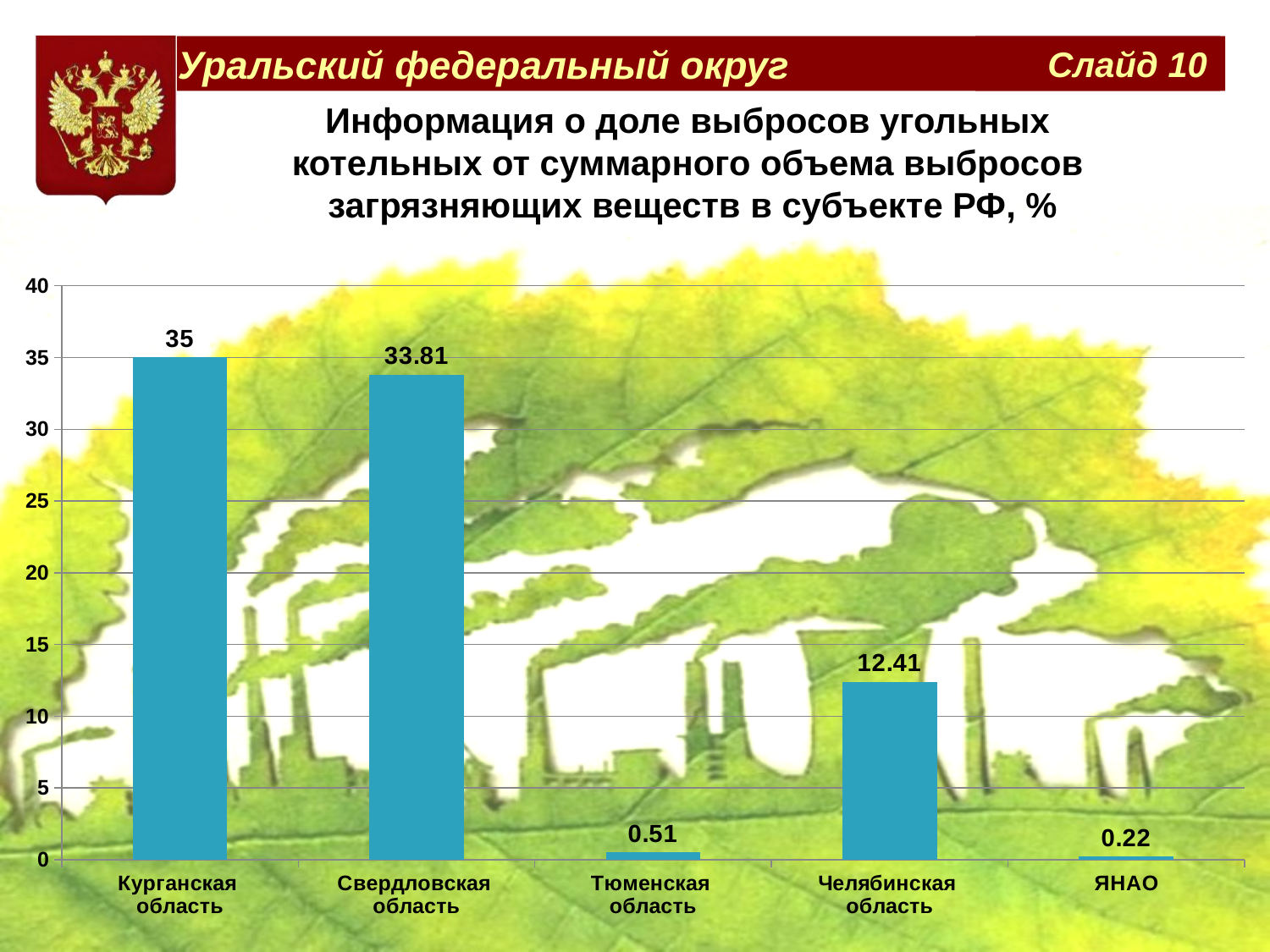
How many categories are shown on the x axis? 5 What is the difference between the values for Курганская область and Челябинская область? 22.59 What is the value for Курганская область? 35 What kind of chart is shown on the slide? bar chart Which category has the lowest value? ЯНАО What is the value for Свердловская область? 33.81 Is the value for Челябинская область greater or less than 10? greater What is the value for ЯНАО? 0.22 What is the value for Челябинская область? 12.41 Which is larger, the value for Свердловская область or the value for Челябинская область? Свердловская область Which category has the highest value? Курганская область What is the value for Тюменская область? 0.51